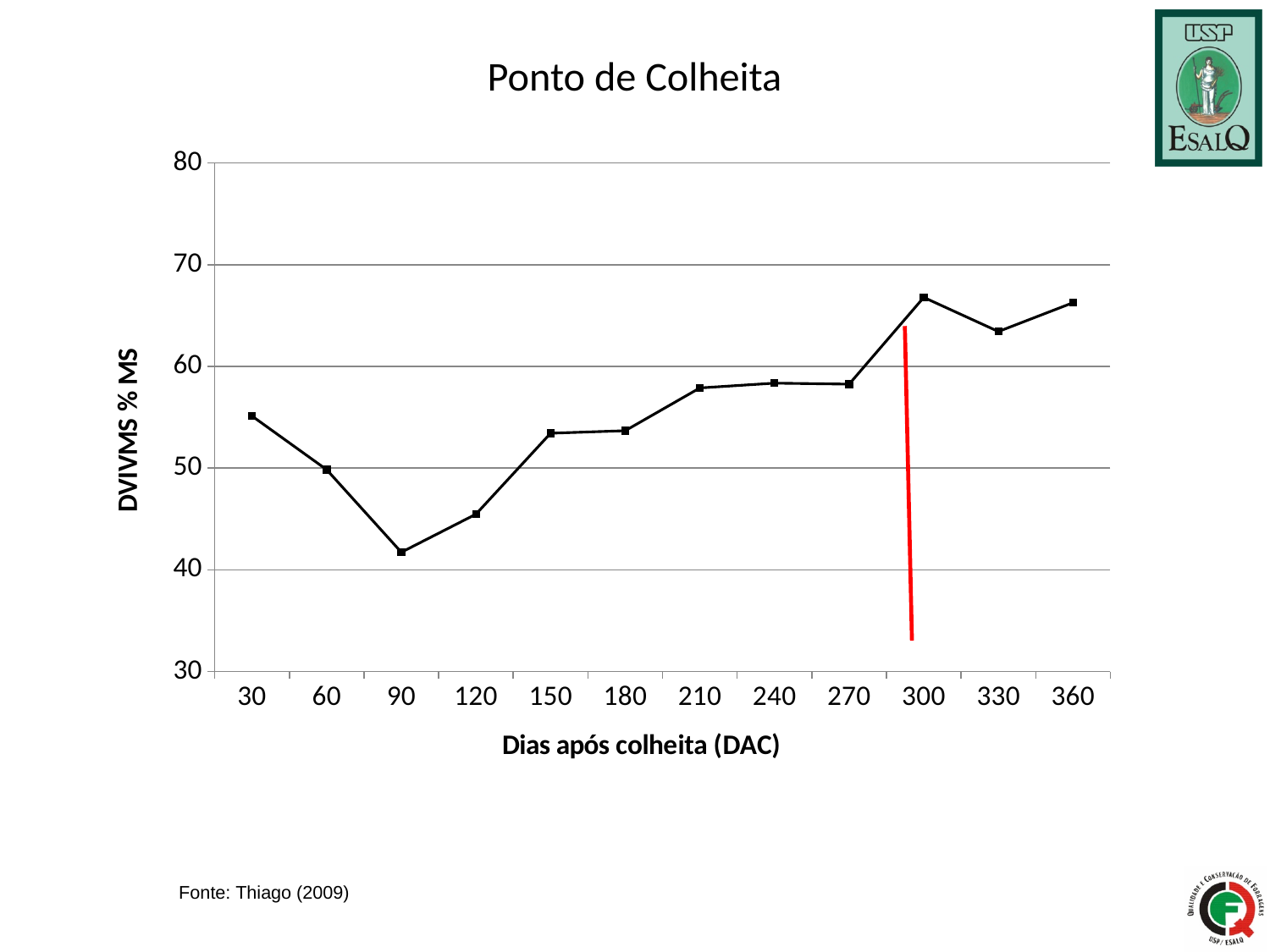
Do the values rise or fall between 90 DAC and 300 DAC? rise Which has the higher DVIVMS % MS, 30 DAC or 90 DAC? 30 Is the value for 300 DAC greater or less than 60? greater What kind of chart is shown on the slide? line chart Is the value for 210 DAC greater or less than 60? less Which has the higher DVIVMS % MS, 150 DAC or 300 DAC? 300 Is the value for 30 DAC greater or less than 50? greater At which value of Dias após colheita (DAC) is DVIVMS % MS lowest? 90 What is the title of the x axis? Dias após colheita (DAC) How many data points are plotted on the line? 12